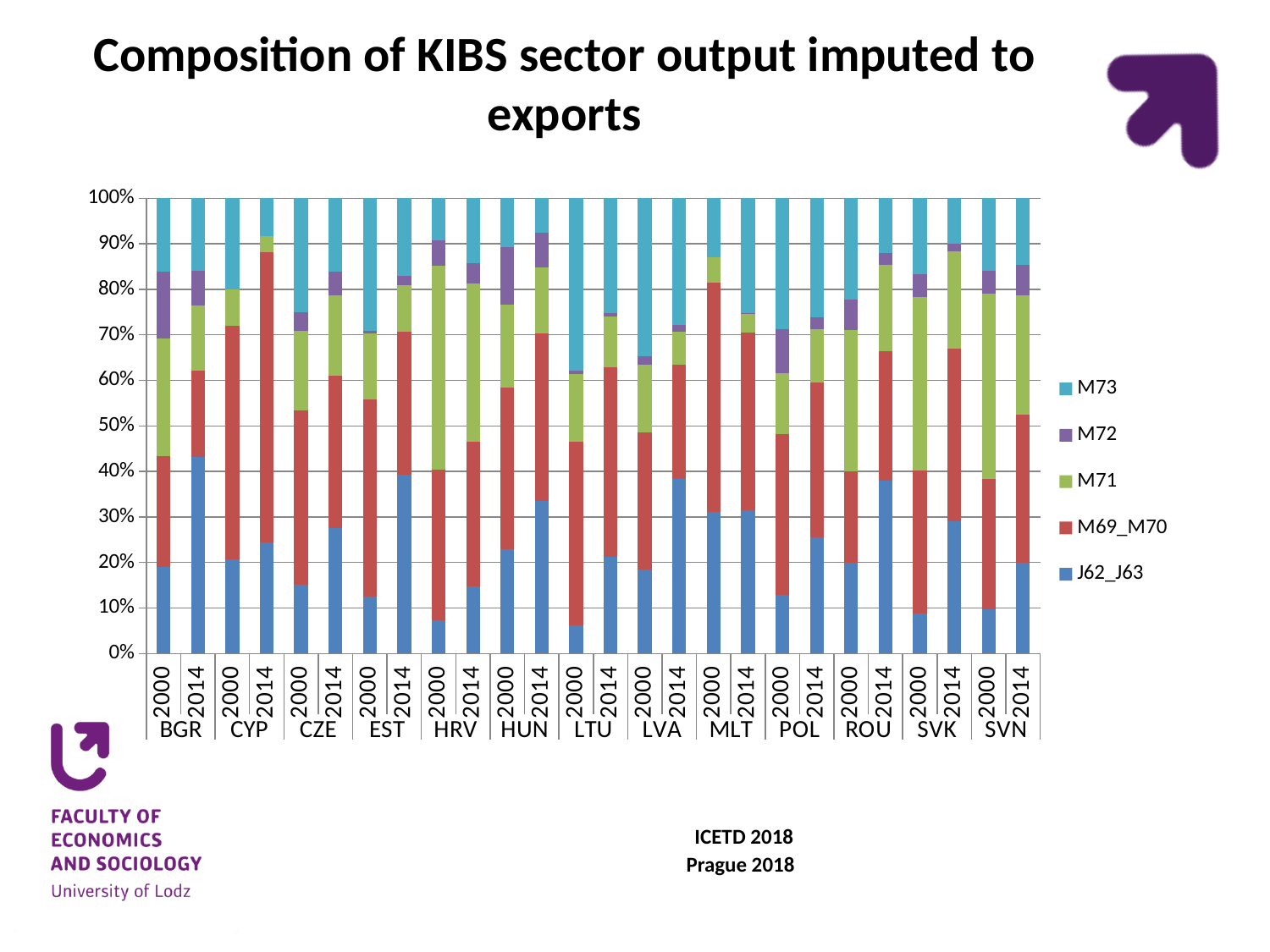
How many series does the legend list? 5 Is the M69_M70 share for CYP larger in 2000 or in 2014? 2014 What kind of chart is shown on the slide? Stacked bar chart Which series is listed at the bottom of the legend? J62_J63 How many bars are plotted in the chart? 26 Is the J62_J63 share for BGR larger in 2000 or in 2014? 2014 Is the J62_J63 share for HRV in 2000 greater or less than 10%? less Is the J62_J63 share for LTU in 2000 greater or less than 10%? less Which bar has the largest J62_J63 share? BGR 2014 Is the J62_J63 share for BGR in 2014 greater or less than 40%? greater What is the title of the chart? Composition of KIBS sector output imputed to exports How many countries are shown along the x axis? 13